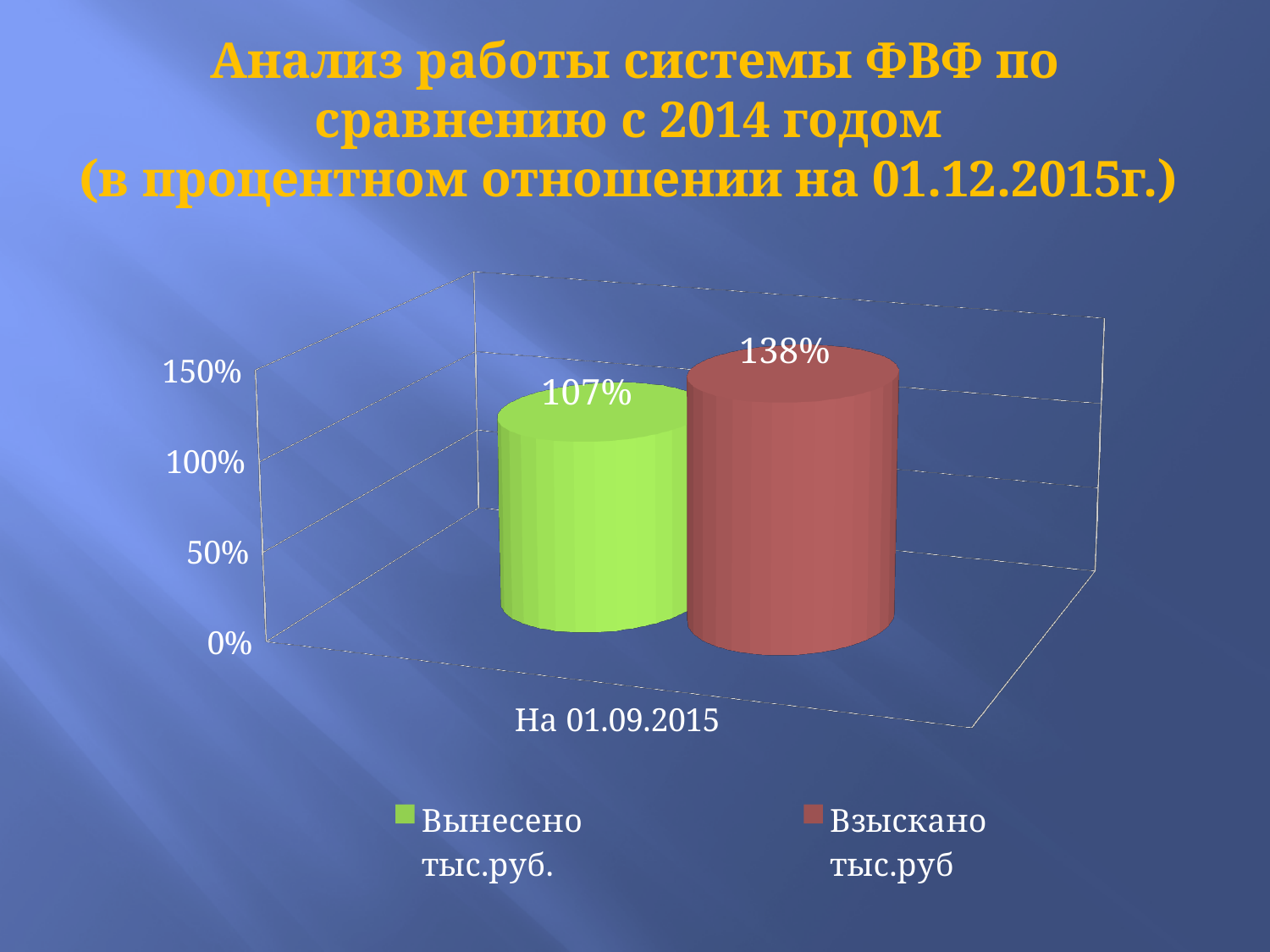
How many categories are shown on the x axis? 1 Which series has the higher value, "Вынесено тыс.руб." or "Взыскано тыс.руб"? Взыскано тыс.руб What kind of chart is shown on the slide? bar chart What is the difference between the "Взыскано тыс.руб" value and the "Вынесено тыс.руб." value? 31% What is the category label on the x axis? На 01.09.2015 What colour is the bar for "Взыскано тыс.руб"? red How many series does the legend list? 2 Is the value for "Взыскано тыс.руб" greater or less than 150%? less Is the value for "Вынесено тыс.руб." greater or less than 100%? greater What is the value for "Вынесено тыс.руб." on 01.09.2015? 107% What is the value for "Взыскано тыс.руб" on 01.09.2015? 138% Which series has the lowest value? Вынесено тыс.руб.